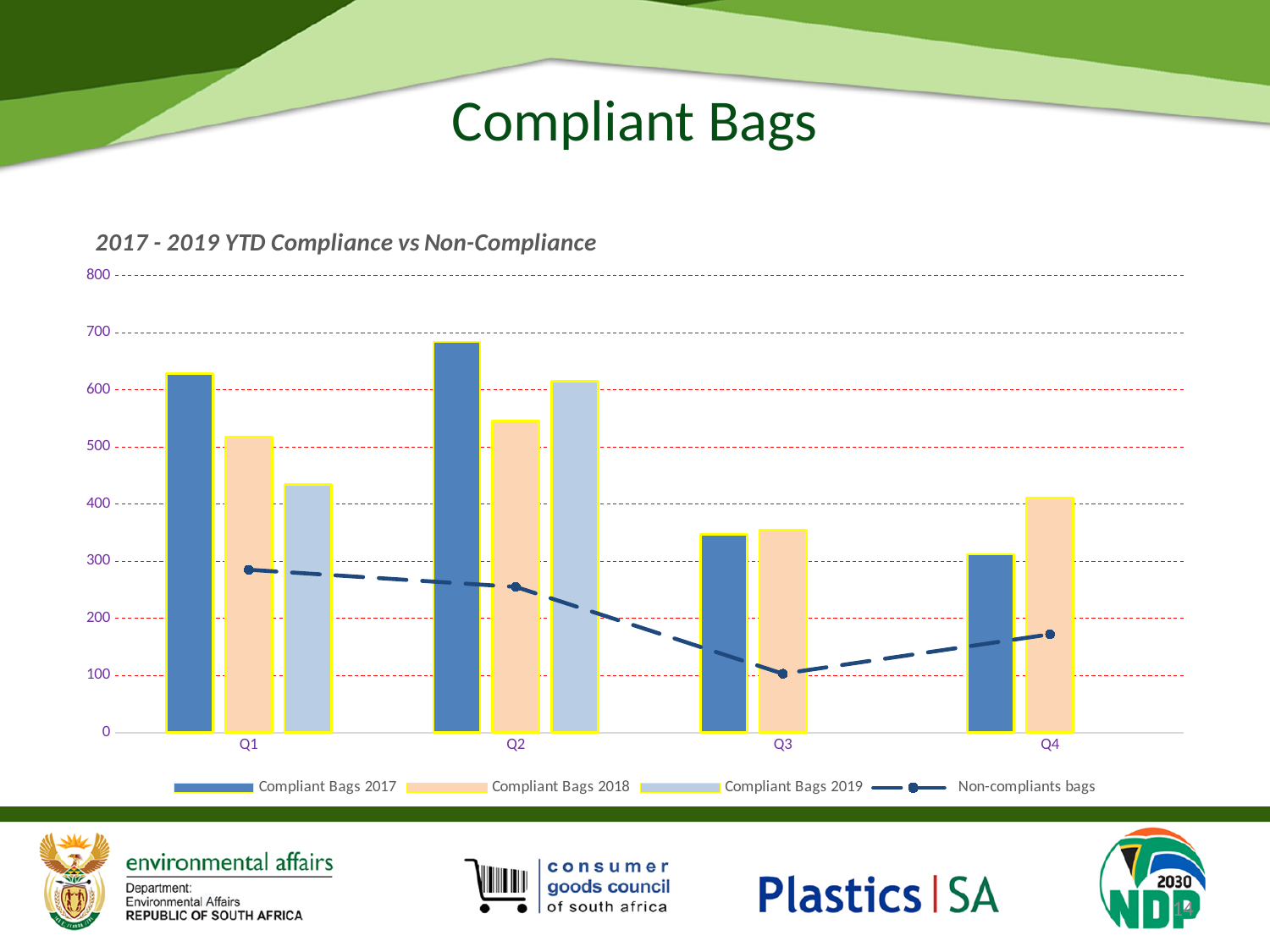
How many series does the chart legend list? 4 How many quarters are shown on the x axis of the chart? 4 Is the Compliant Bags 2019 value for Q1 greater or less than 500? less Is the Compliant Bags 2017 value for Q1 greater or less than 600? greater In which quarter is the Non-compliants bags value lowest? Q3 In Q1, which is larger: Compliant Bags 2017 or Compliant Bags 2018? Compliant Bags 2017 In Q4, which is larger: Compliant Bags 2017 or Compliant Bags 2018? Compliant Bags 2018 In which quarter is the Compliant Bags 2017 value lowest? Q4 What kind of chart is shown on the slide? bar chart with a line What is the title of the chart? 2017 - 2019 YTD Compliance vs Non-Compliance In which quarter is the Compliant Bags 2017 value highest? Q2 Is the Non-compliants bags value for Q3 greater or less than 200? less